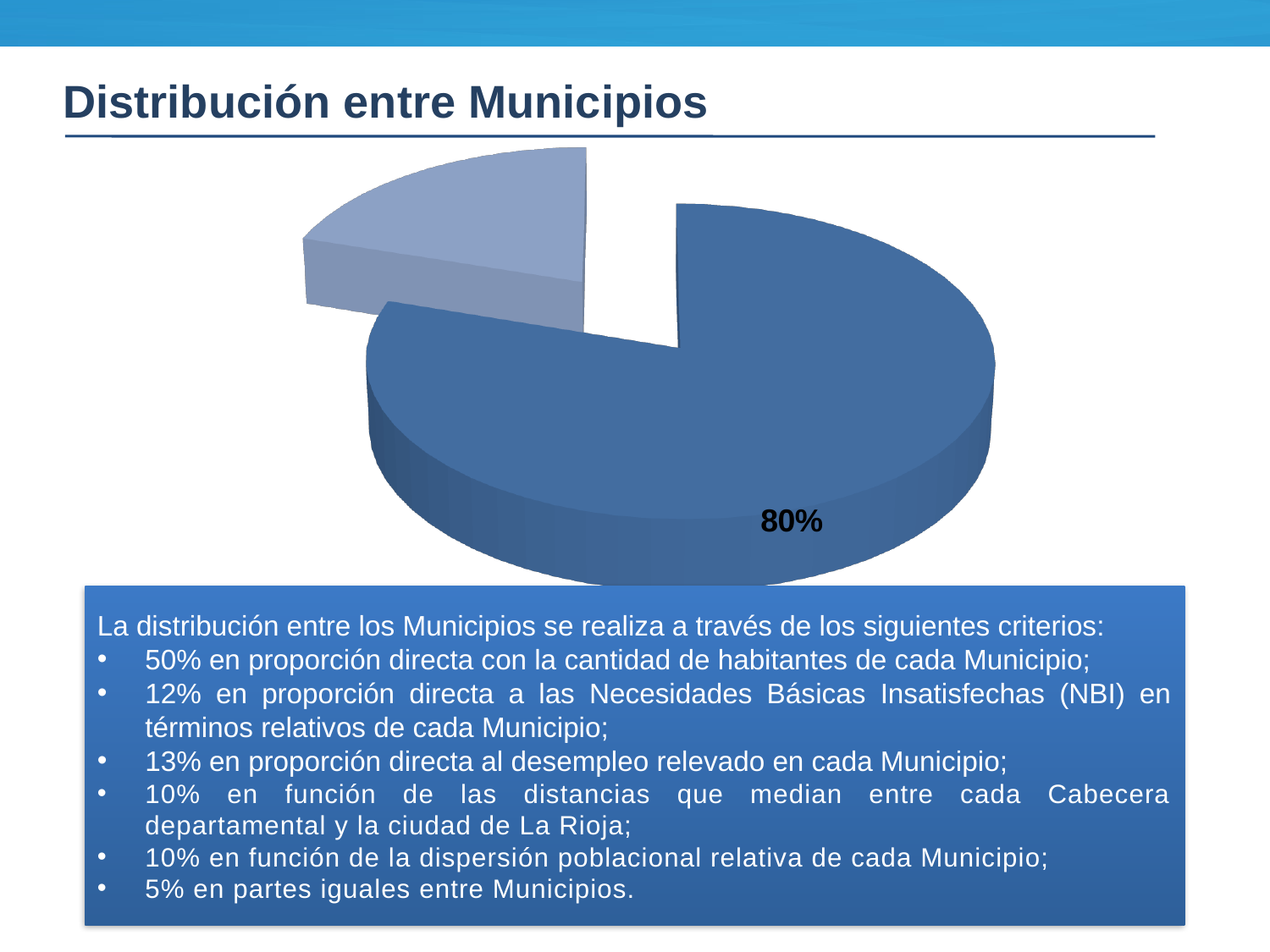
What kind of chart is shown on the slide? pie chart Is the dark blue slice of the pie chart greater or less than 50% of the pie? greater What colour is the slice labelled 80% in the pie chart? dark blue What percentage is printed on the large dark blue slice of the pie chart? 80% Which slice of the pie chart is larger, the dark blue one or the light blue one? dark blue How many slices does the pie chart have? 2 Is the light blue slice of the pie chart greater or less than 50% of the pie? less What is the value of the largest slice in the pie chart? 80% What is the title of the slide containing the pie chart? Distribución entre Municipios